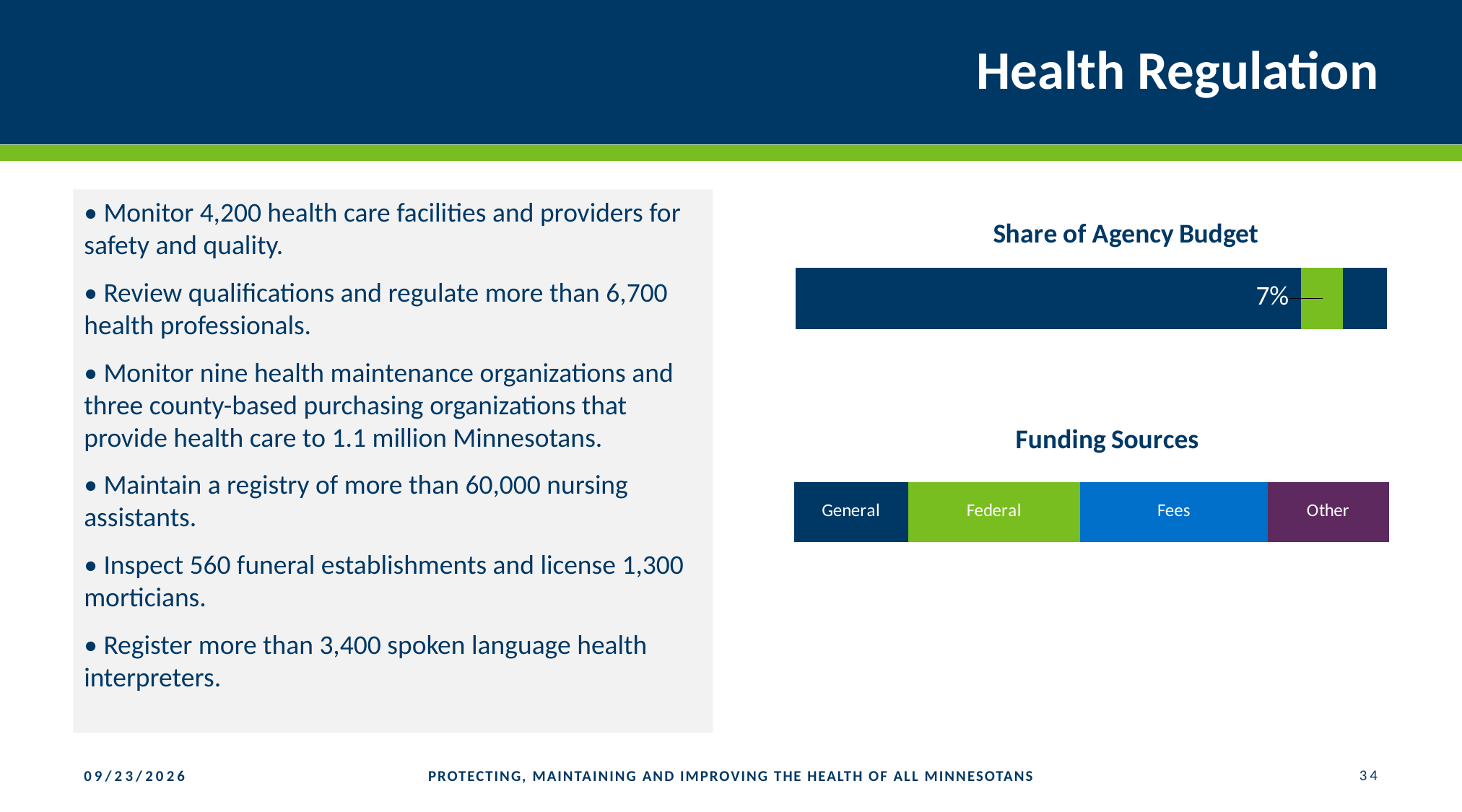
What kind of chart is the Share of Agency Budget chart? bar chart What kind of chart is the Funding Sources chart? bar chart In the Funding Sources chart, which segment is larger, General or Fees? Fees What is the title of the chart at the top right of the slide? Share of Agency Budget In the Funding Sources chart, what is the label of the first (leftmost) segment? General In the Funding Sources chart, which segment is larger, Other or Federal? Federal In the Funding Sources chart, how many funding source segments are shown? 4 In the Funding Sources chart, which segment is larger, Fees or General? Fees In the Share of Agency Budget chart, what percentage is printed as the data label? 7%